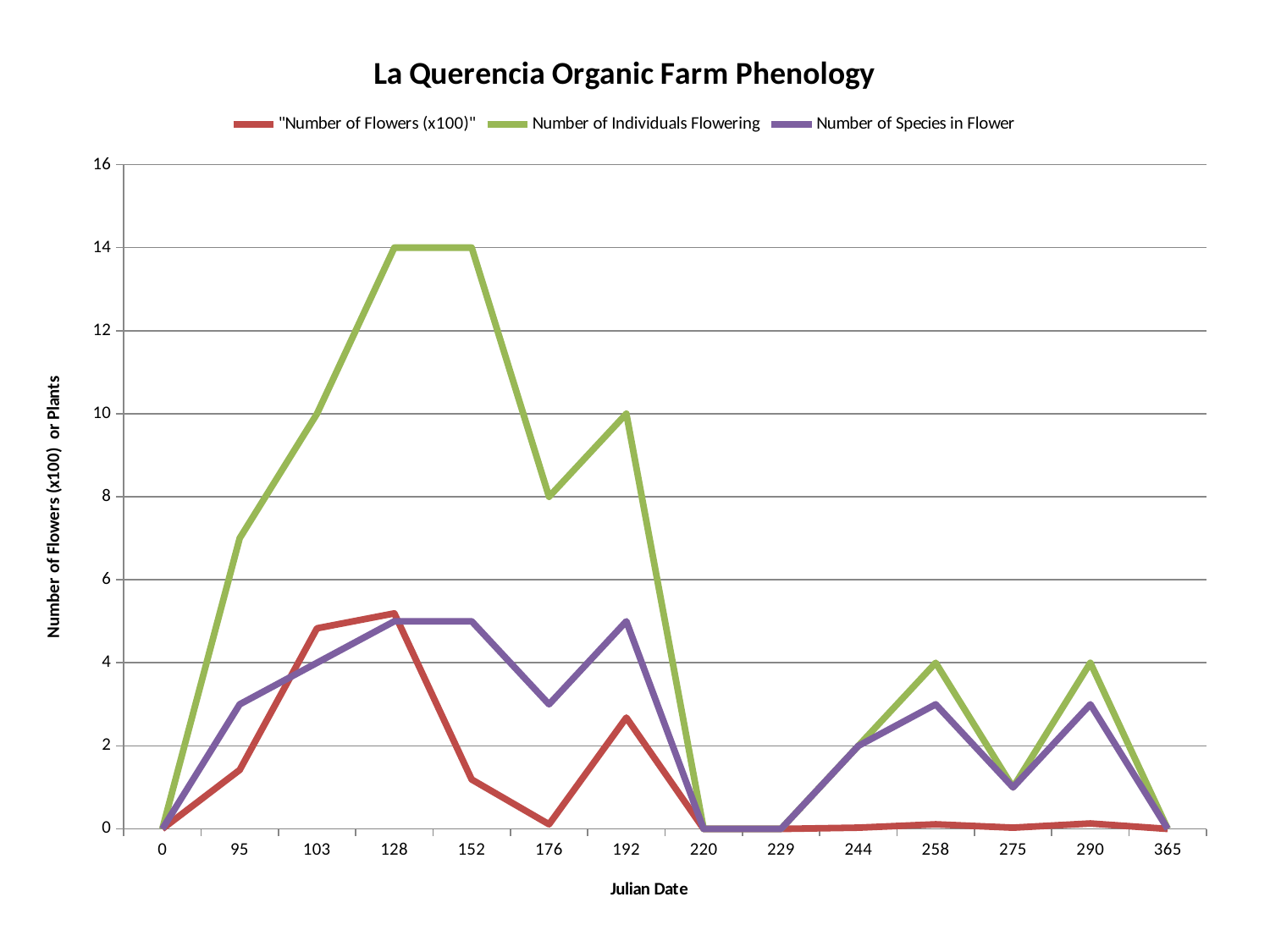
Which series reaches the highest value on the chart? Number of Individuals Flowering What is the title of the x axis? Julian Date What kind of chart is shown on the slide? line chart How many Julian Date points are shown along the x axis? 14 What is the value of Number of Individuals Flowering at Julian Date 192? 10 How many series does the legend list? 3 What is the value of Number of Individuals Flowering at Julian Date 176? 8 Is the value for "Number of Flowers (x100)" at Julian Date 103 greater or less than 4? greater What is the difference between Number of Individuals Flowering at Julian Date 128 and at Julian Date 192? 4 What is the value of Number of Individuals Flowering at Julian Date 128? 14 Is the value for Number of Species in Flower at Julian Date 95 greater or less than 2? greater At Julian Date 192, which is larger: Number of Individuals Flowering or Number of Species in Flower? Number of Individuals Flowering